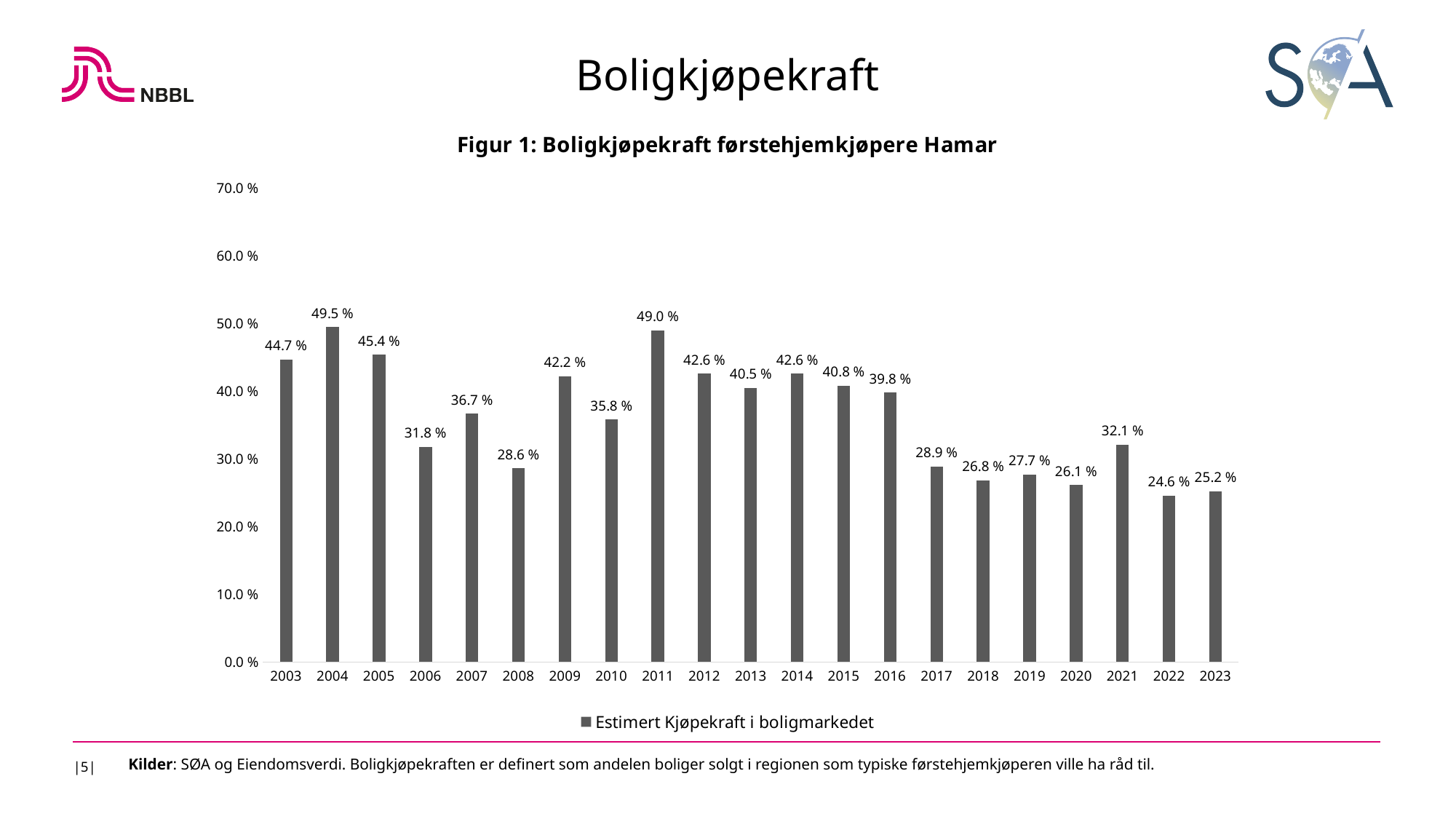
What is the difference between the values for 2003 and 2023? 19.5 percentage points Which year has the lowest value in the chart? 2022 Which is larger, the value for 2007 or the value for 2010? 2007 What kind of chart is shown on the slide? Bar chart What is the value for 2008 in the chart? 28.6 % Is the value for 2016 greater or less than 40.0 %? less What is the difference between the values for 2021 and 2022? 7.5 percentage points What is the value for 2023 in the chart? 25.2 % What is the value for 2011 in the chart? 49.0 % How many series does the legend list? 1 Which year has the highest value in the chart? 2004 How many years are shown on the x axis of the chart? 21